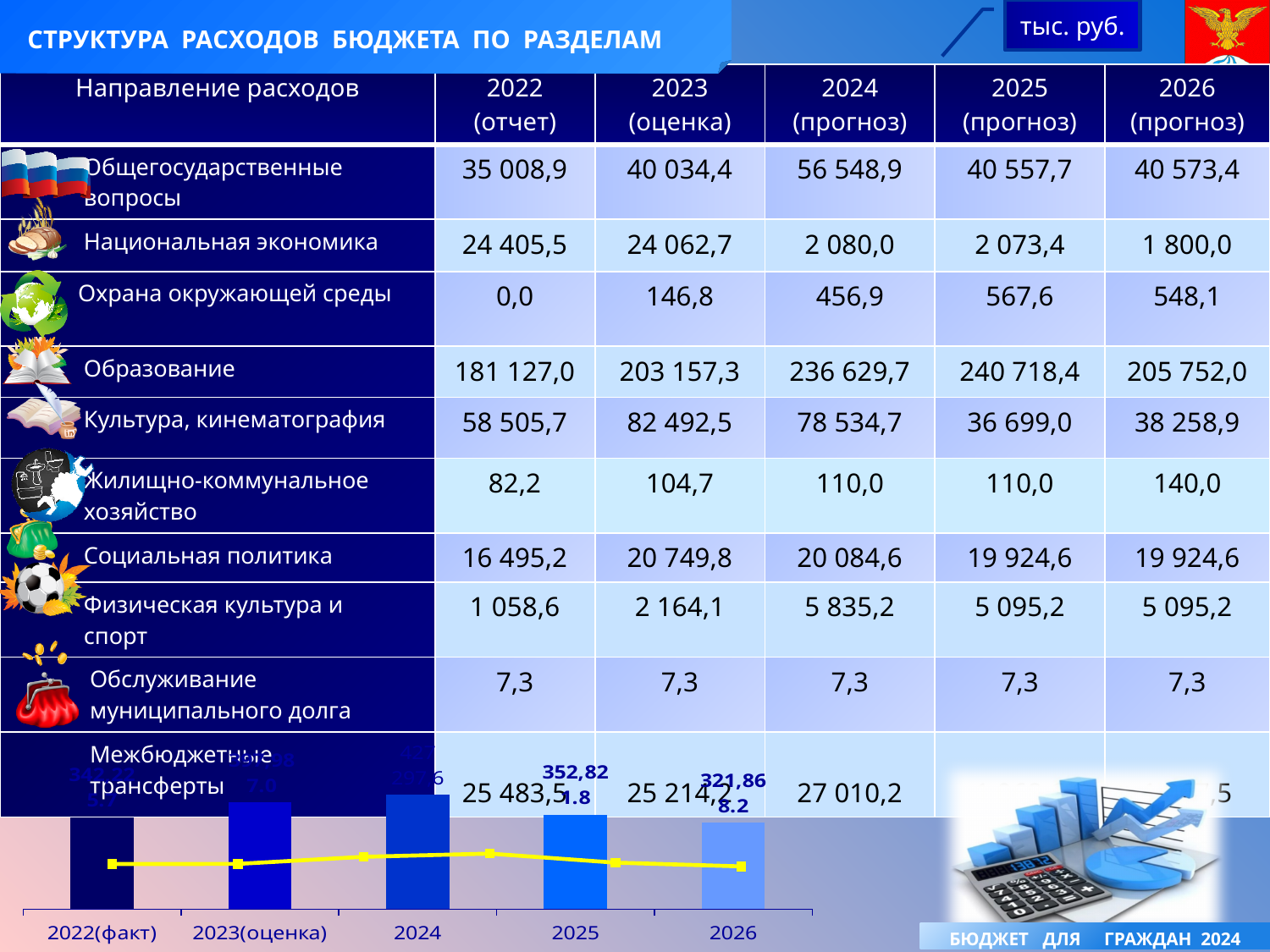
In the chart at the bottom of the slide, what value is labelled on the bar for 2026? 321,868.2 In the chart at the bottom of the slide, which bar is taller: 2022(факт) or 2024? 2024 What is the label of the first category on the x axis of the chart at the bottom of the slide? 2022(факт) How many categories are shown on the x axis of the chart at the bottom of the slide? 5 What colour is the line plotted across the bars in the chart at the bottom of the slide? yellow In the chart at the bottom of the slide, what is the difference between the labelled bar values for 2025 and 2026? 30,953.6 In the chart at the bottom of the slide, what value is labelled on the bar for 2025? 352,821.8 What kind of chart is shown at the bottom of the slide? bar chart with a line In the chart at the bottom of the slide, do the bars rise or fall from 2024 to 2026? fall In the chart at the bottom of the slide, which bar is taller: 2025 or 2026? 2025 In the chart at the bottom of the slide, which year has the tallest bar? 2024